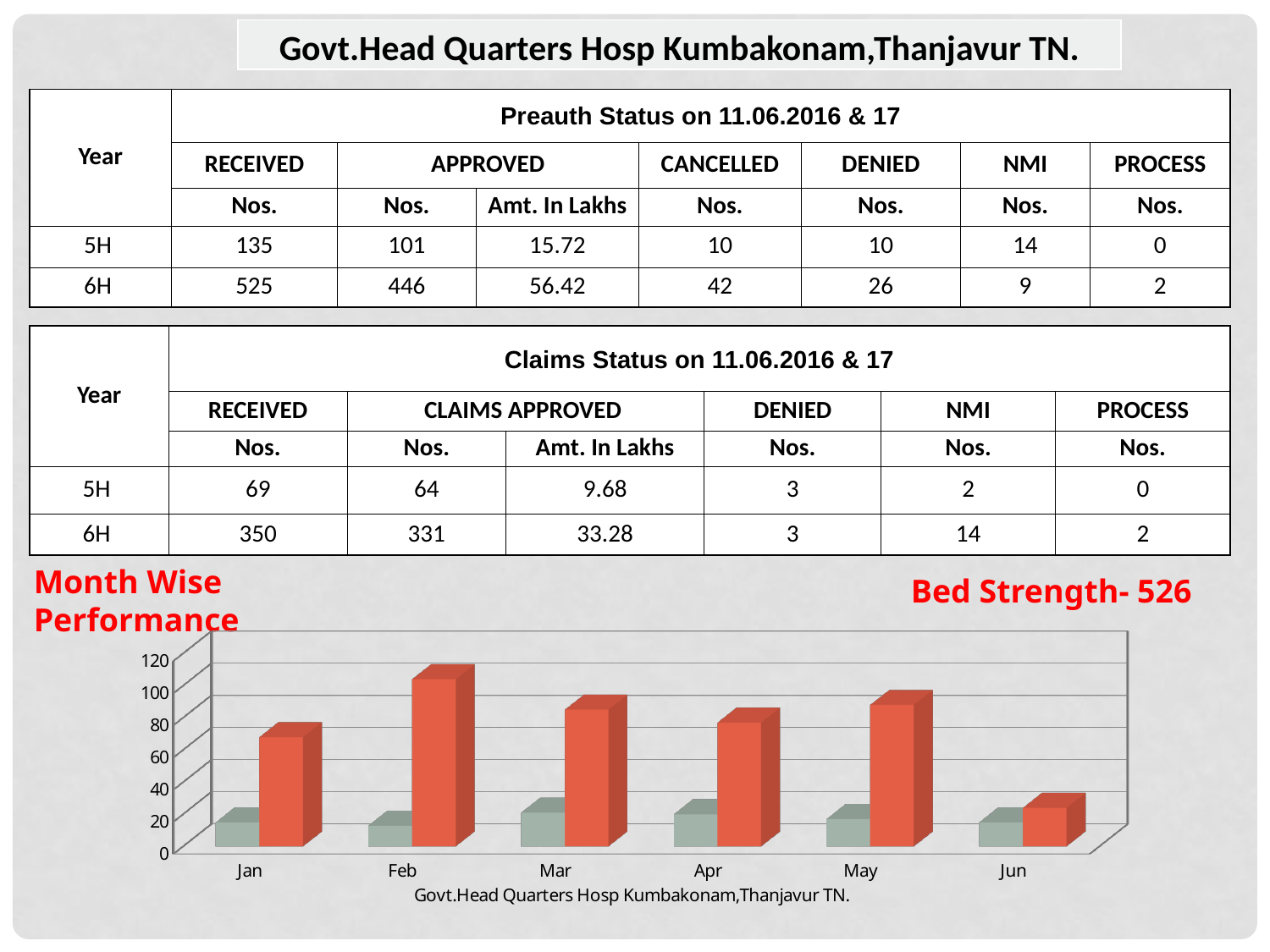
Is the orange bar for Jan greater or less than 40? greater Which month has the larger orange bar, Jan or Feb? Feb Is the orange bar for Feb greater or less than 80? greater Is the grey bar for Apr greater or less than 40? less Which month has the shortest orange bar in the chart? Jun What kind of chart is shown under the 'Month Wise Performance' heading? bar chart Which month has the tallest orange bar in the chart? Feb Which month has the larger orange bar, May or Jun? May What is the title printed below the bar chart? Govt.Head Quarters Hosp Kumbakonam,Thanjavur TN. How many months are shown on the x axis of the bar chart? 6